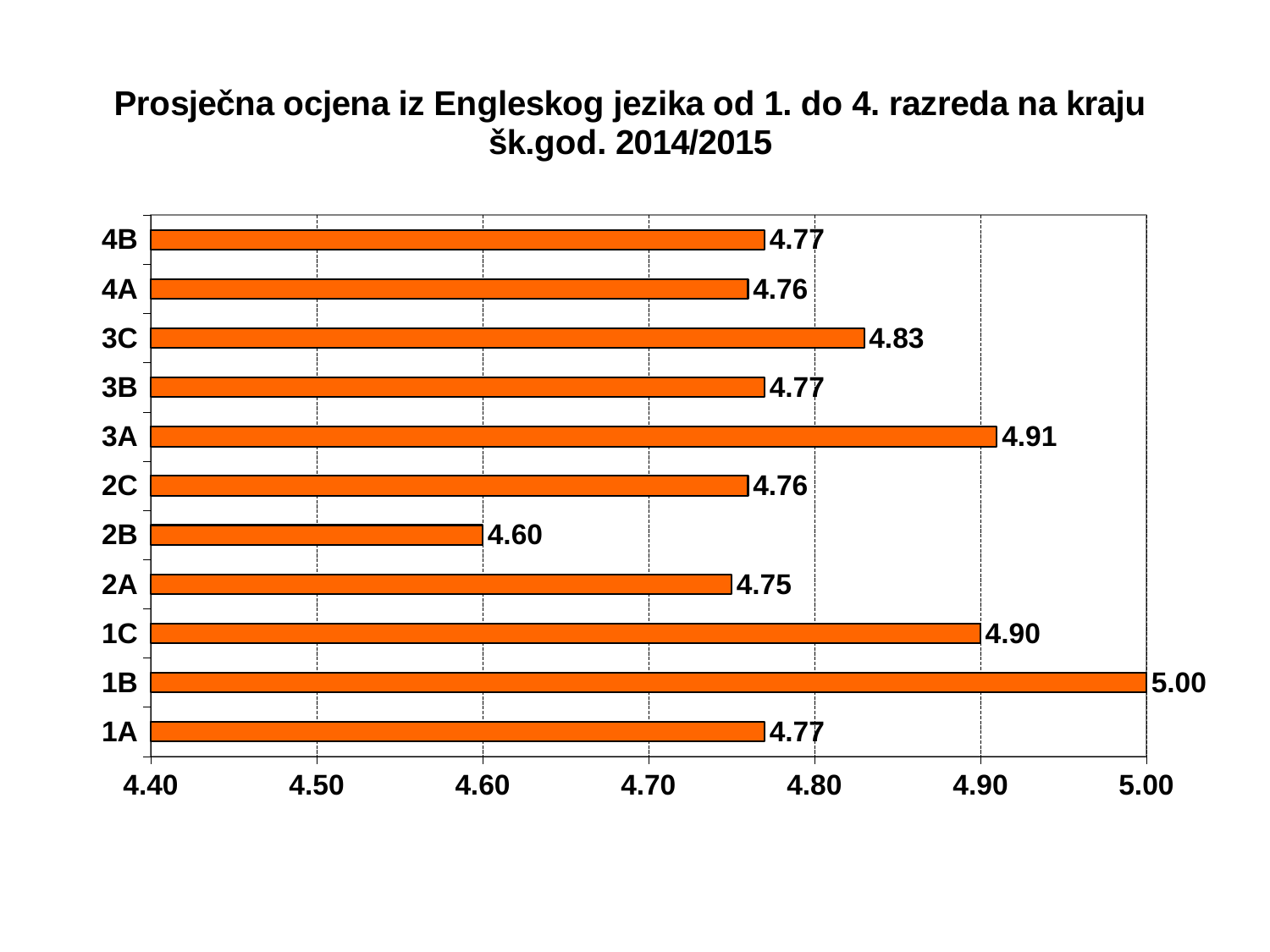
Which class has a higher average grade, 1C or 2A? 1C What is the average English grade for class 3A? 4.91 What is the difference between the average grades of class 3A and class 3C? 0.08 Which class has the highest average English grade? 1B What is the title of the chart? Prosječna ocjena iz Engleskog jezika od 1. do 4. razreda na kraju šk.god. 2014/2015 What is the difference between the average grades of class 1B and class 2B? 0.40 What is the average English grade for class 3C? 4.83 How many classes are shown in the chart? 11 Which class has a higher average grade, 3C or 4A? 3C What kind of chart is shown on the slide? Bar chart Which class has the lowest average English grade? 2B What is the average English grade for class 2B? 4.60